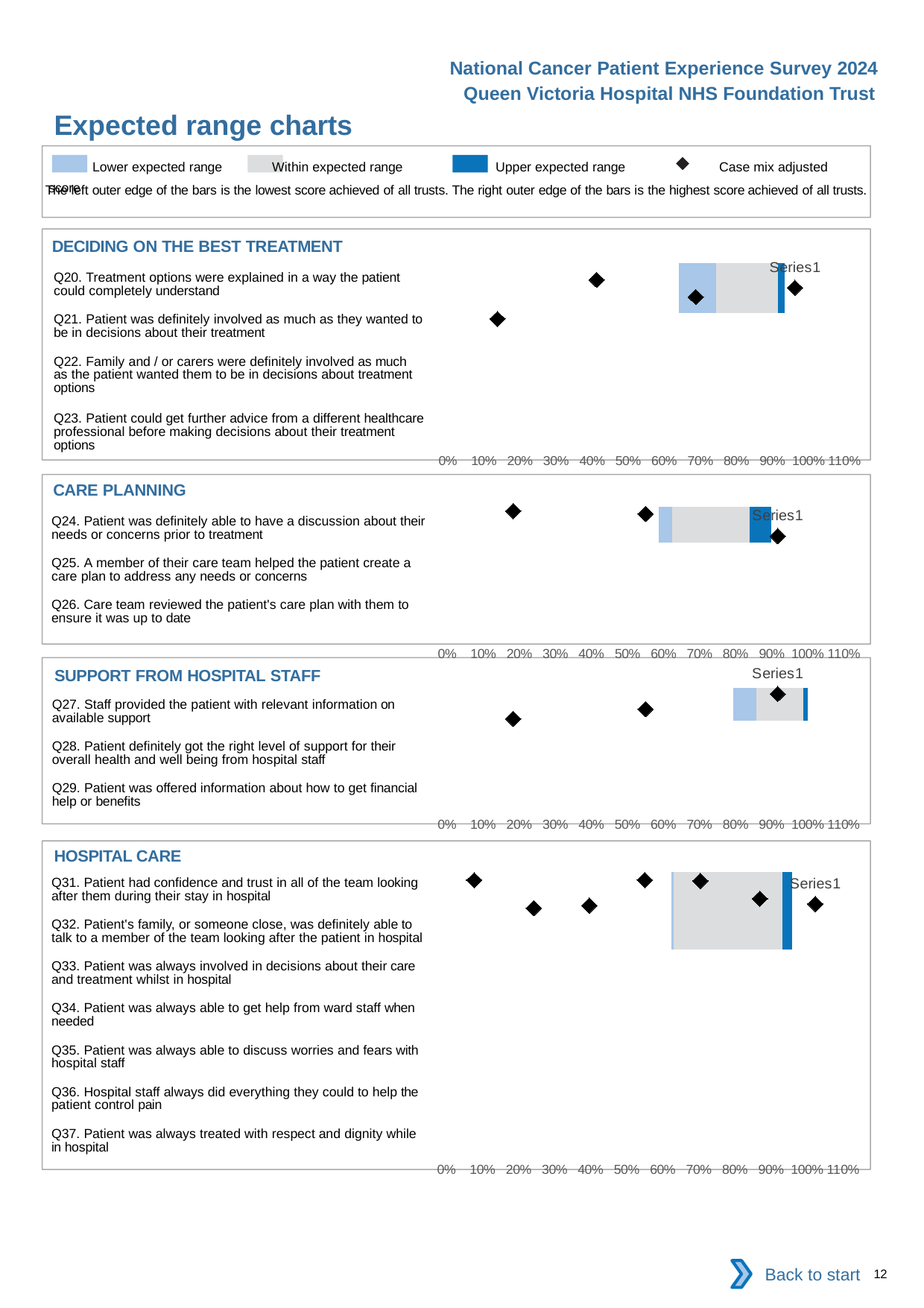
How many questions are listed in the 'Care planning' chart? 3 What kind of chart is used in the 'Deciding on the best treatment' section? bar chart In the 'Hospital care' chart, is the left edge of the shaded expected range bar greater or less than 50%? greater How many questions are listed in the 'Deciding on the best treatment' chart? 4 In the 'Support from hospital staff' chart, is the left edge of the shaded expected range bar greater or less than 70%? greater How many entries does the legend at the top of the slide list? 4 How many diamond markers are plotted in the 'Hospital care' chart? 7 According to the legend, what does the black diamond marker represent? Case mix adjusted score What is the highest tick label shown on the x axis of the 'Care planning' chart? 110% In the 'Care planning' chart, is the right edge of the shaded expected range bar greater or less than 80%? greater